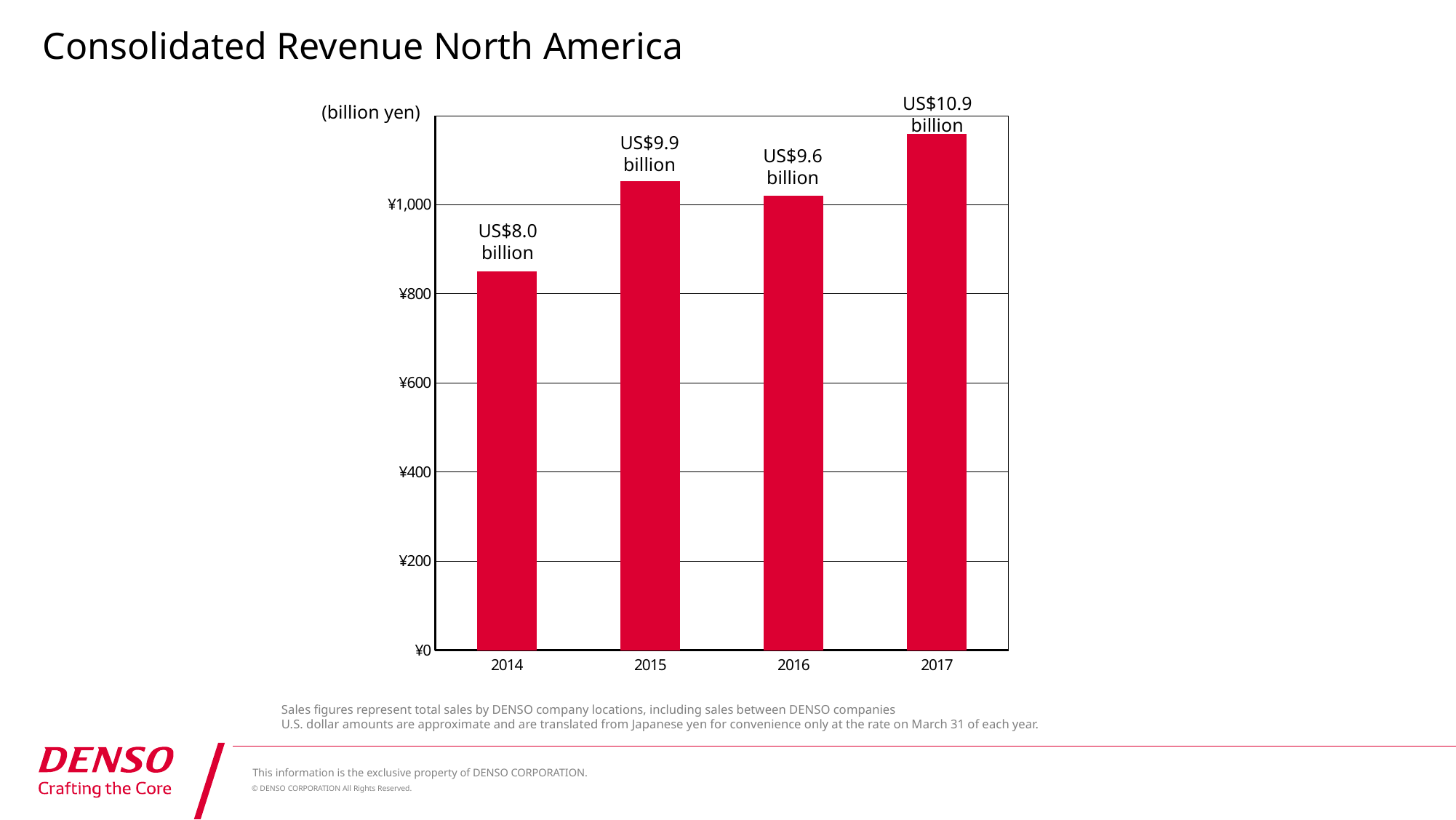
Which year has the larger revenue, 2015 or 2016? 2015 Which year has the lowest consolidated revenue? 2014 What is the US dollar data label shown for 2014? US$8.0 billion What type of chart is shown on the slide? Bar chart What is the US dollar data label shown for 2017? US$10.9 billion What unit is indicated for the vertical axis of the chart? billion yen Is the value for 2014 greater or less than ¥1,000? less How many years are shown on the chart? 4 Is the value for 2017 greater or less than ¥1,000? greater Which year has the highest consolidated revenue? 2017 By how much does the US dollar label for 2017 exceed the US dollar label for 2014? US$2.9 billion What is the US dollar data label shown for 2016? US$9.6 billion